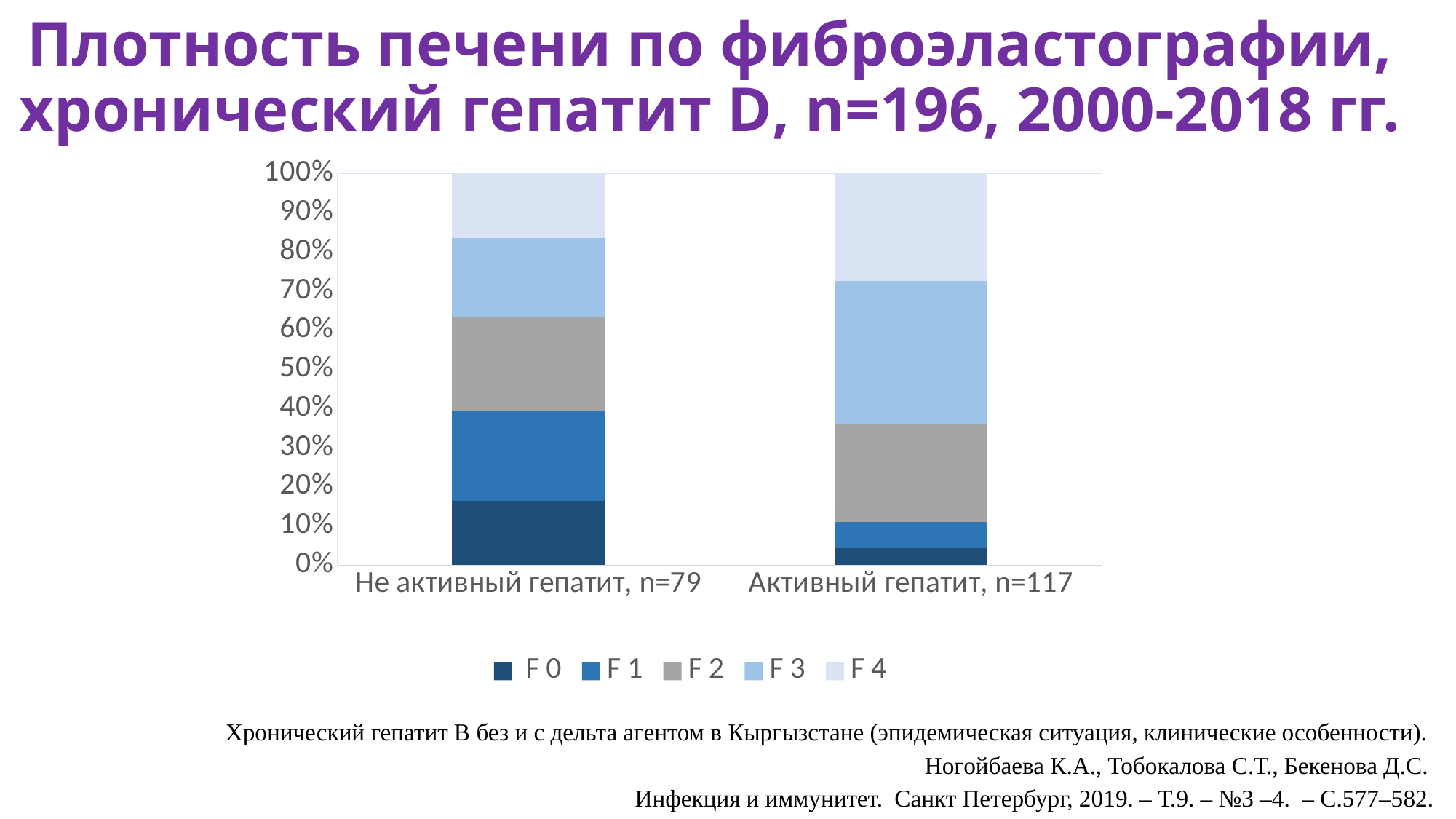
How many categories (bars) are shown on the x axis? 2 Is the F 0 share for 'Активный гепатит, n=117' greater or less than 10%? less What is the label of the second bar on the x axis? Активный гепатит, n=117 What kind of chart is shown on the slide? Stacked bar chart Which bar has the larger F 3 segment, 'Не активный гепатит, n=79' or 'Активный гепатит, n=117'? Активный гепатит, n=117 Is the F 4 share for 'Активный гепатит, n=117' greater or less than 20%? greater What does each stacked bar total on the y axis? 100% Is the F 0 share for 'Не активный гепатит, n=79' greater or less than 10%? greater Which bar has the larger F 0 segment, 'Не активный гепатит, n=79' or 'Активный гепатит, n=117'? Не активный гепатит, n=79 What are the series names listed in the legend? F 0, F 1, F 2, F 3, F 4 How many series does the legend list? 5